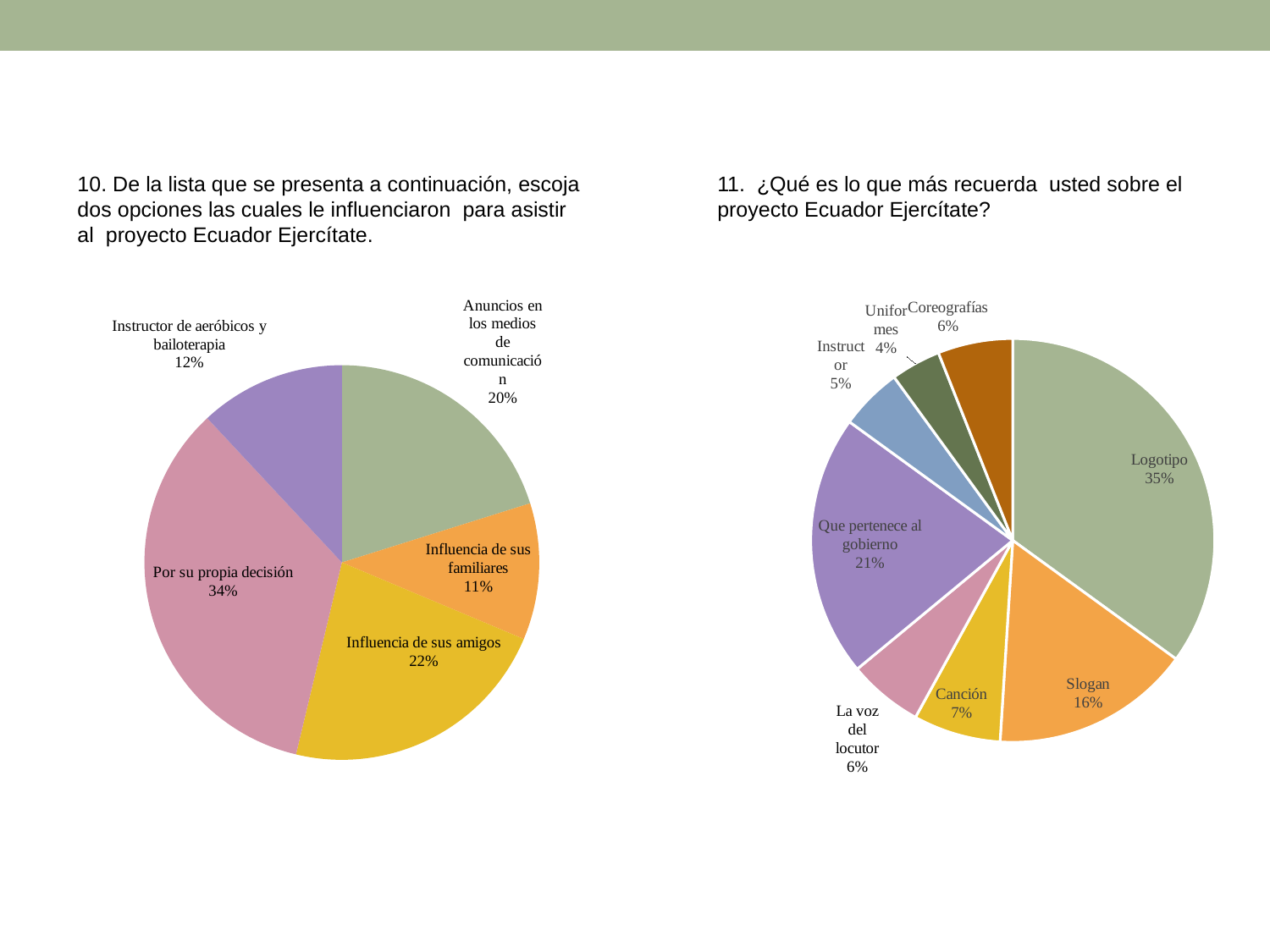
In the left pie chart, which category has the largest slice? Por su propia decisión In the right pie chart, which is larger: 'Slogan' or 'Canción'? Slogan What type of chart is shown on the right side of the slide? Pie chart In the left pie chart, what share is labelled for 'Por su propia decisión'? 34% How many slices does the left pie chart have? 5 In the left pie chart, which category has the smallest slice? Influencia de sus familiares In the left pie chart, what share is labelled for 'Influencia de sus amigos'? 22% In the right pie chart, what share is labelled for 'Logotipo'? 35% In the right pie chart, what share is labelled for 'Que pertenece al gobierno'? 21% In the right pie chart, which category has the smallest slice? Uniformes In the left pie chart, what is the difference between the shares for 'Influencia de sus amigos' and 'Influencia de sus familiares'? 11% How many slices does the right pie chart have? 8